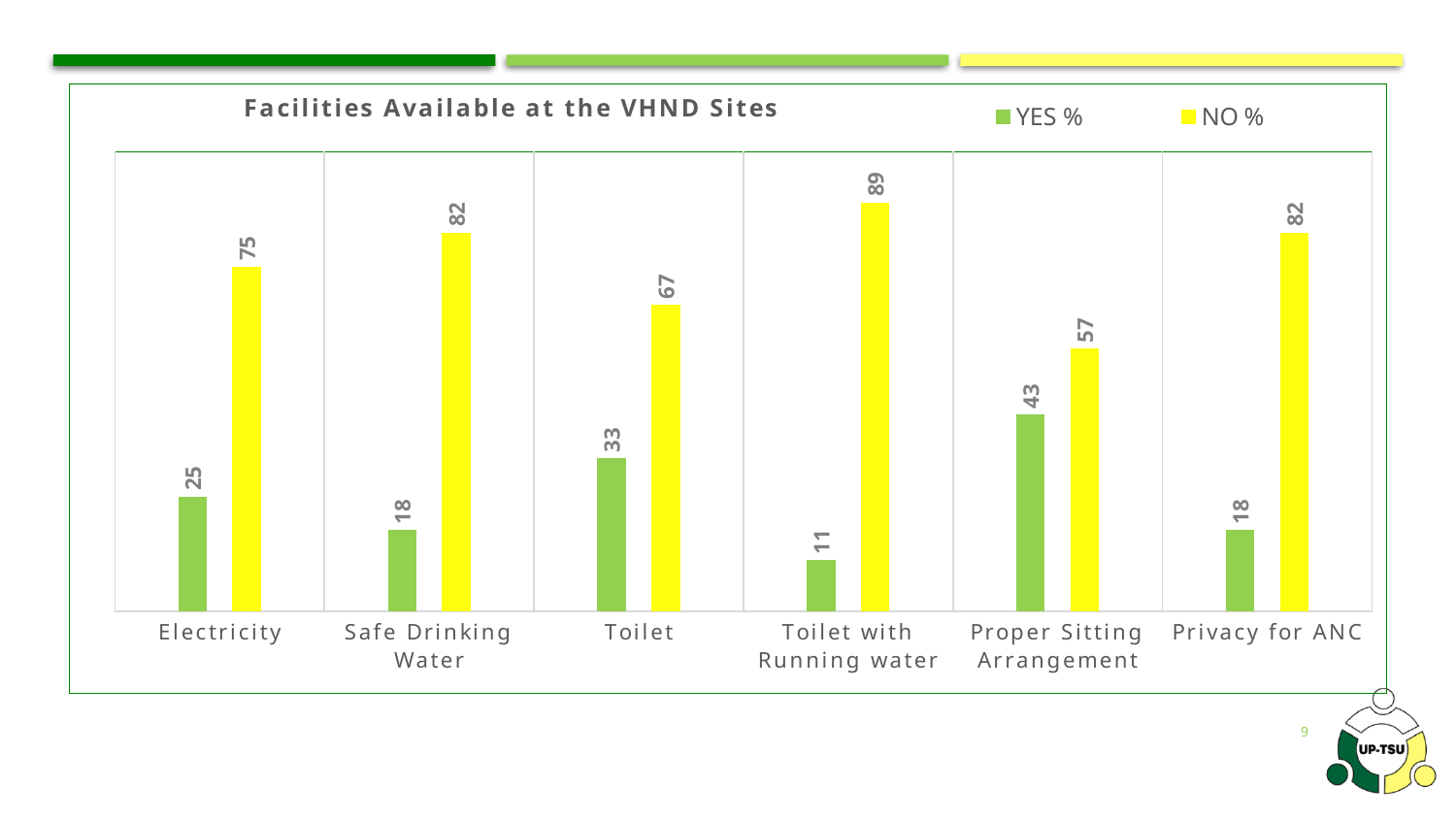
Which is larger, the YES % value for Proper Sitting Arrangement or the YES % value for Toilet? Proper Sitting Arrangement What is the NO % value for Toilet with Running water? 89 Which category has the lowest YES % value? Toilet with Running water What is the title of the chart? Facilities Available at the VHND Sites What is the YES % value for Electricity? 25 What colour are the NO % bars? Yellow How many categories are shown on the x axis? 6 How many series does the legend list? 2 What kind of chart is shown on the slide? Bar chart What is the difference between the NO % and YES % values for Toilet? 34 What is the YES % value for Proper Sitting Arrangement? 43 Which category has the highest NO % value? Toilet with Running water